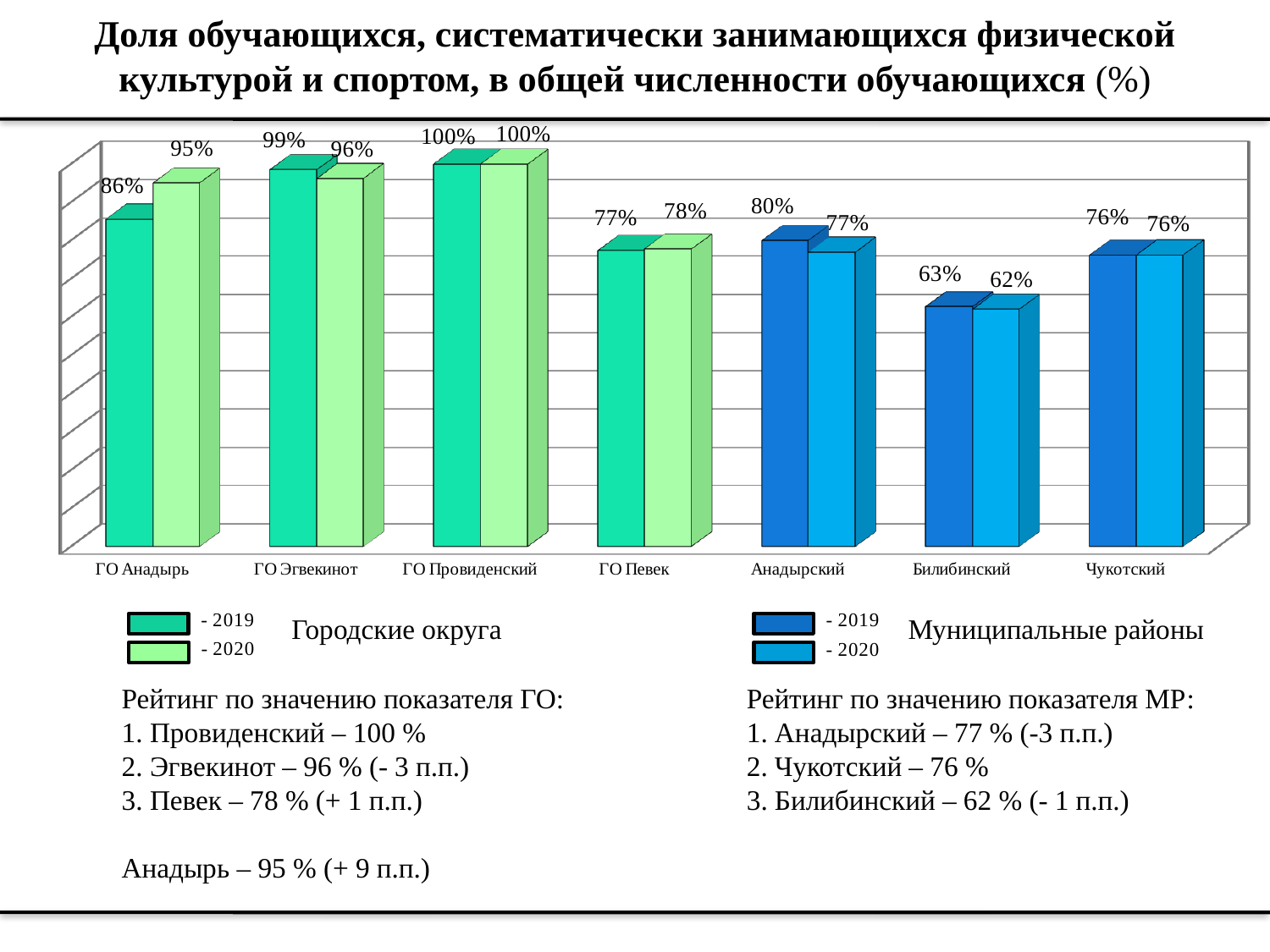
Which category has the highest 2020 value? ГО Провиденский How many categories are shown on the x axis? 7 Which group of categories is shown in blue bars? Муниципальные районы Which category has the lowest 2019 value? Билибинский How many years does the legend compare for each category? 2 What is the 2019 value for ГО Эгвекинот? 99% What kind of chart is shown on the slide? Bar chart What is the difference between the 2019 values of ГО Провиденский and Чукотский? 24 percentage points What is the difference between the 2020 and 2019 values for ГО Анадырь? 9 percentage points What is the 2019 value for Билибинский? 63% Which is larger for Анадырский: the 2019 value or the 2020 value? 2019 What is the 2020 value for ГО Анадырь? 95%